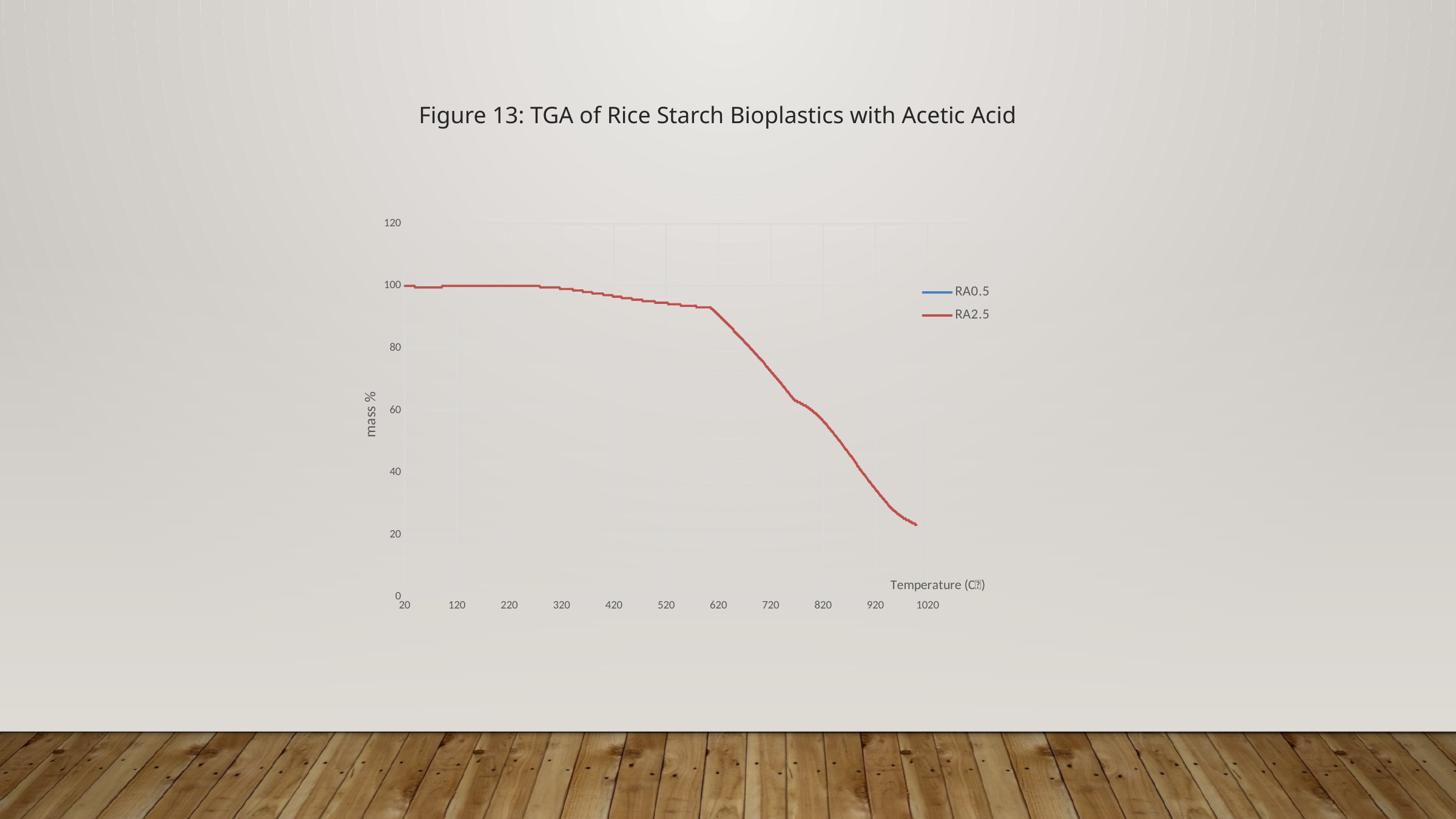
What is the highest value shown on the vertical axis? 120 Is the mass % of RA2.5 at a temperature of 920 greater or less than 60? less What is the label of the vertical axis? mass % What is the title of the chart? Figure 13: TGA of Rice Starch Bioplastics with Acetic Acid Is the mass % of RA2.5 at a temperature of 720 greater or less than 100? less How many series does the legend list? 2 What kind of chart is shown on the slide? line chart Is the mass % of RA2.5 at a temperature of 320 greater or less than 80? greater Does the RA2.5 series rise or fall as temperature increases along the x axis? fall